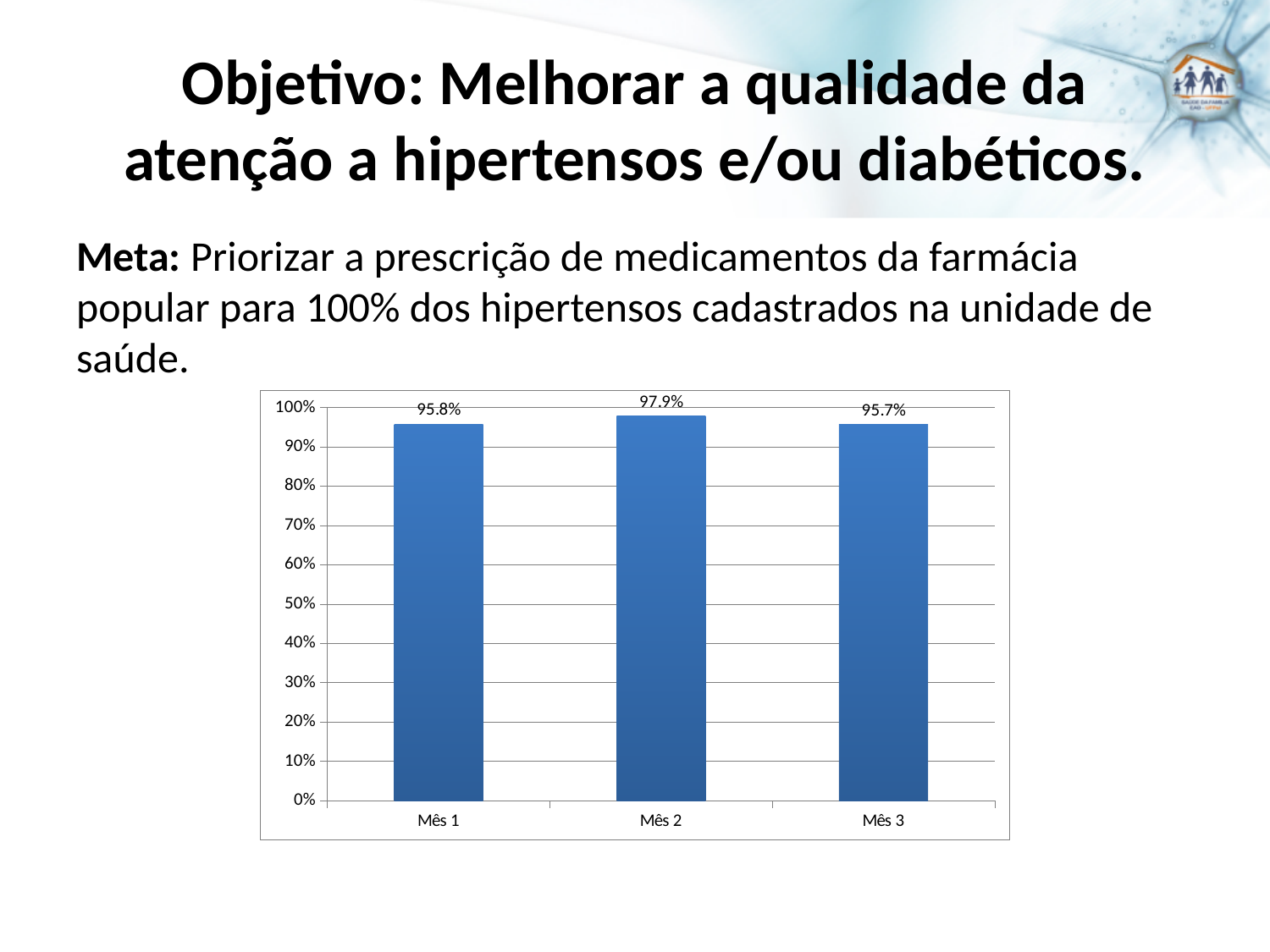
Which is larger, the value for Mês 2 or the value for Mês 3? Mês 2 What is the value for Mês 1? 95.8% What is the difference between the values for Mês 2 and Mês 1? 2.1% Which month has the highest value? Mês 2 Is the value for Mês 1 greater or less than 90%? greater How many categories are shown on the x axis? 3 What kind of chart is shown on the slide? bar chart What is the value for Mês 2? 97.9% What is the value for Mês 3? 95.7% What is the highest value shown on the y axis? 100% Is the value for Mês 2 greater or less than 100%? less What is the difference between the values for Mês 2 and Mês 3? 2.2%